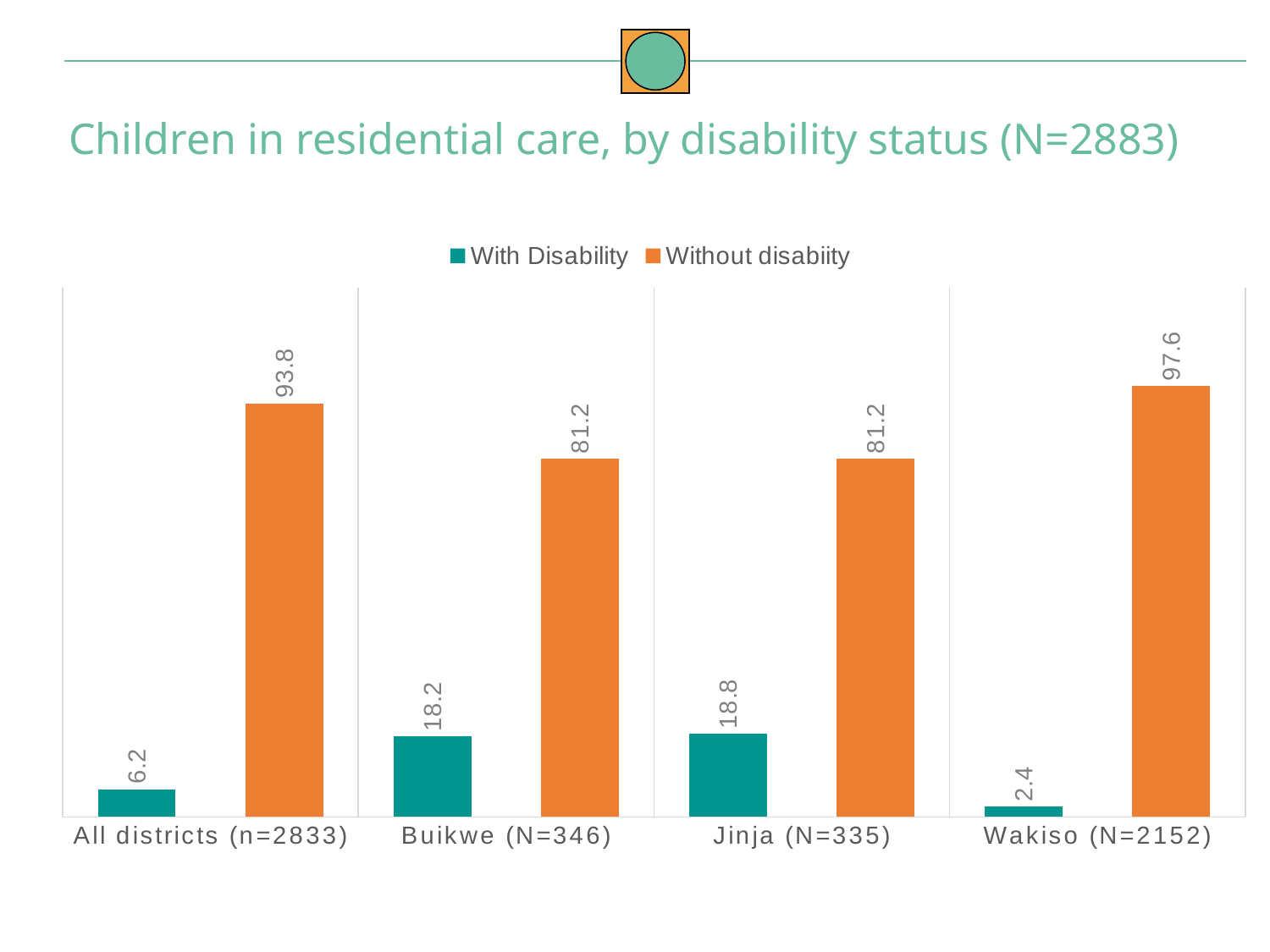
Which category has the lowest value for With Disability? Wakiso (N=2152) Which category has the highest value for Without disabiity? Wakiso (N=2152) What is the title of the slide? Children in residential care, by disability status (N=2883) What is the value for With Disability in Jinja (N=335)? 18.8 What is the difference between the Without disabiity and With Disability values for Buikwe (N=346)? 63 How many categories are shown on the x axis? 4 What is the value for Without disabiity in Wakiso (N=2152)? 97.6 What is the value for With Disability in All districts (n=2833)? 6.2 Which is larger: the With Disability value for Buikwe (N=346) or for Jinja (N=335)? Jinja (N=335) How many series does the legend list? 2 What kind of chart is shown on the slide? Bar chart Which colour represents the With Disability series? Teal